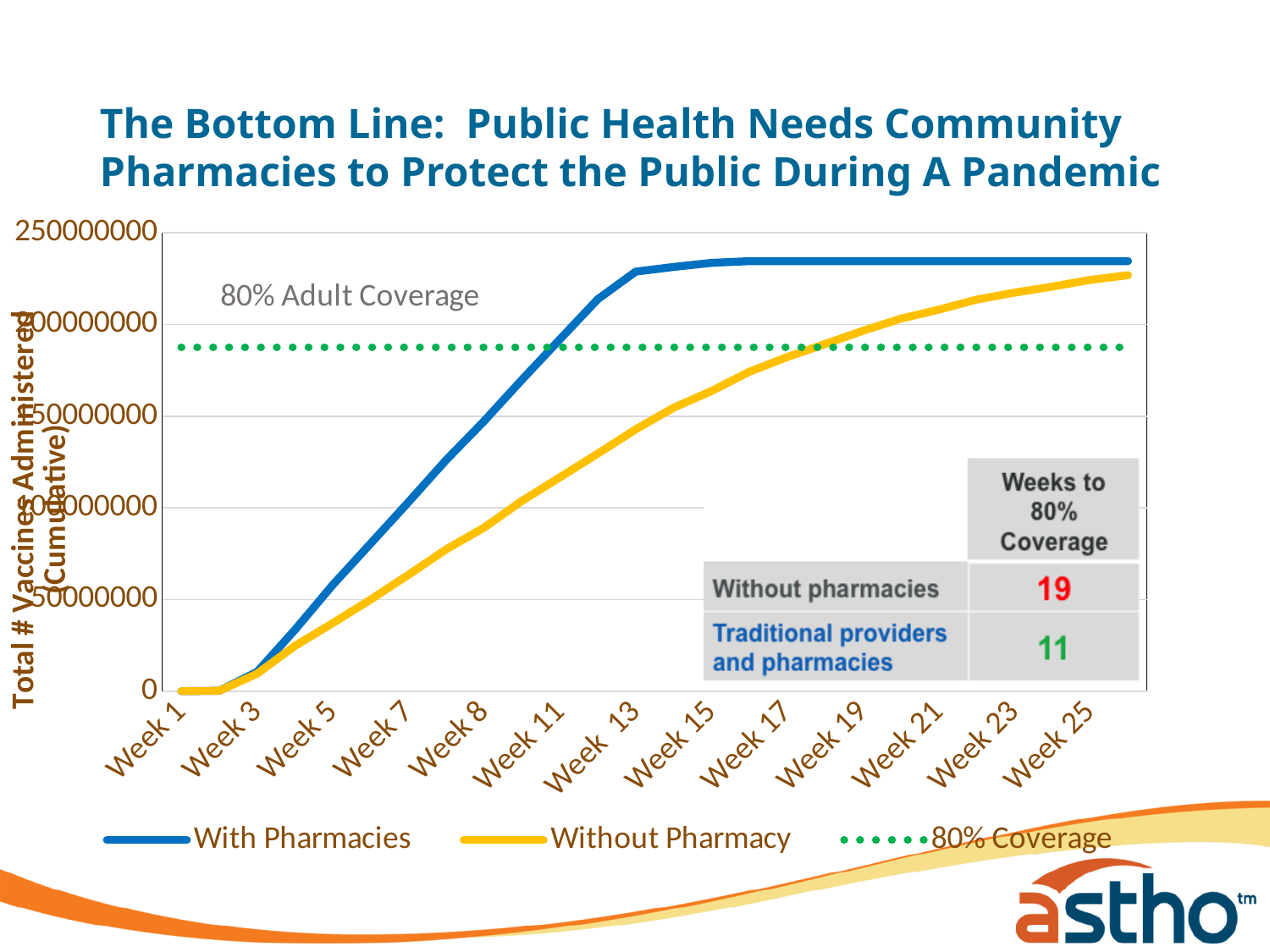
What is the y-axis title of the chart? Total # Vaccines Administered (Cumulative) How many series does the chart legend list? 3 How many week labels are shown on the x axis of the chart? 13 Which series reaches the 80% Coverage line first, With Pharmacies or Without Pharmacy? With Pharmacies Is the value for Without Pharmacy at Week 13 greater or less than 150000000? less How many more weeks to 80% coverage are needed without pharmacies than with traditional providers and pharmacies, according to the table? 8 Does the With Pharmacies line rise or fall from Week 1 to Week 13? rise What kind of chart is shown on the slide? line chart According to the table on the chart, how many weeks to 80% coverage are needed without pharmacies? 19 Is the value for Without Pharmacy at Week 25 greater or less than 200000000? greater According to the table on the chart, how many weeks to 80% coverage are needed with traditional providers and pharmacies? 11 Is the value for With Pharmacies at Week 13 greater or less than 200000000? greater